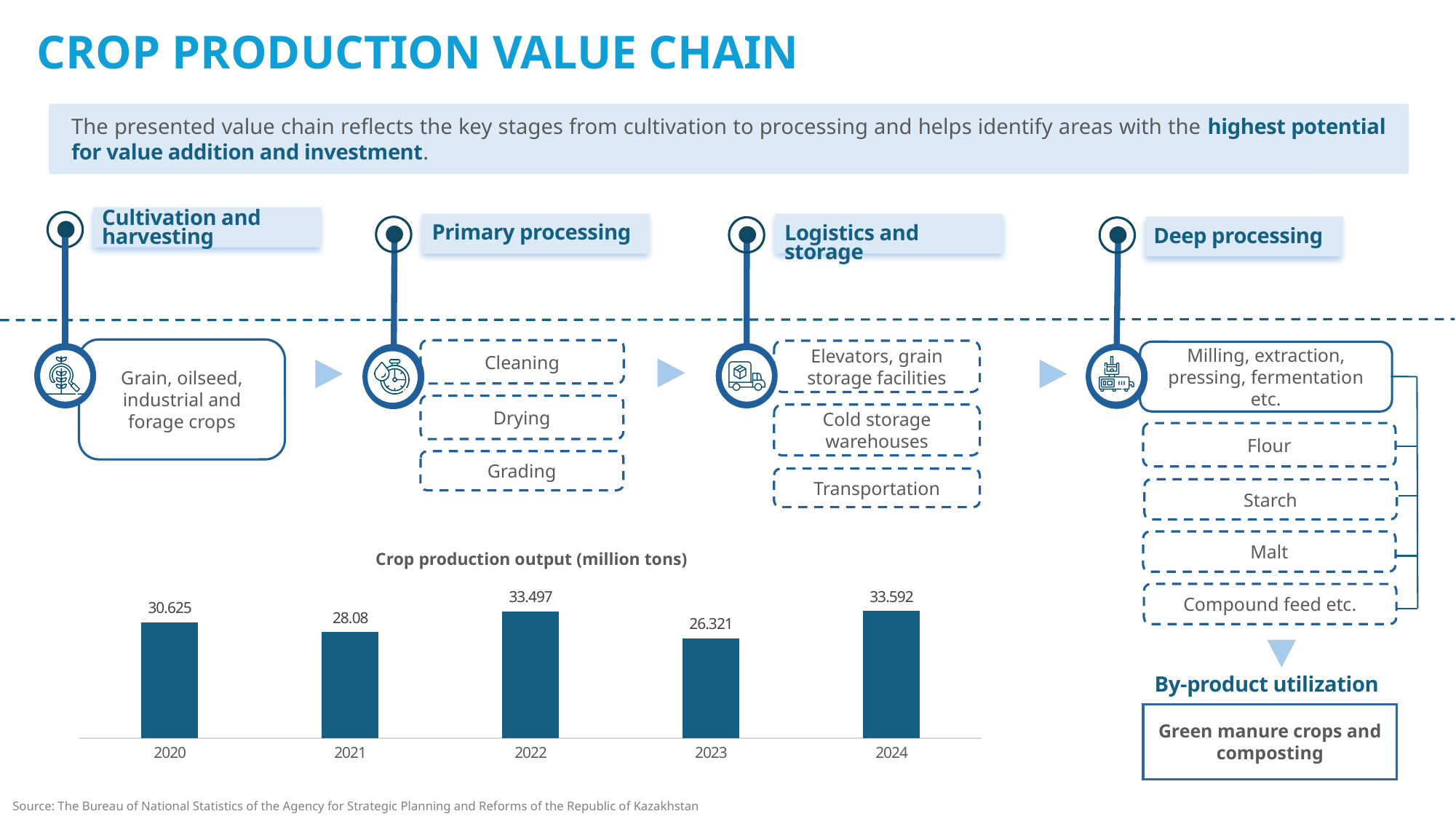
Which year has the lowest crop production output? 2023 What is the difference in crop production output between 2022 and 2021? 5.417 What is the title of the chart on the slide? Crop production output (million tons) What kind of chart is used to show crop production output? Bar chart What is the crop production output for 2023? 26.321 Which year has the larger crop production output, 2020 or 2021? 2020 What is the crop production output for 2024? 33.592 Which year has the highest crop production output? 2024 How many years are shown in the crop production output chart? 5 What is the difference in crop production output between 2024 and 2023? 7.271 What is the crop production output for 2020? 30.625 Did crop production output rise or fall from 2022 to 2023? Fall